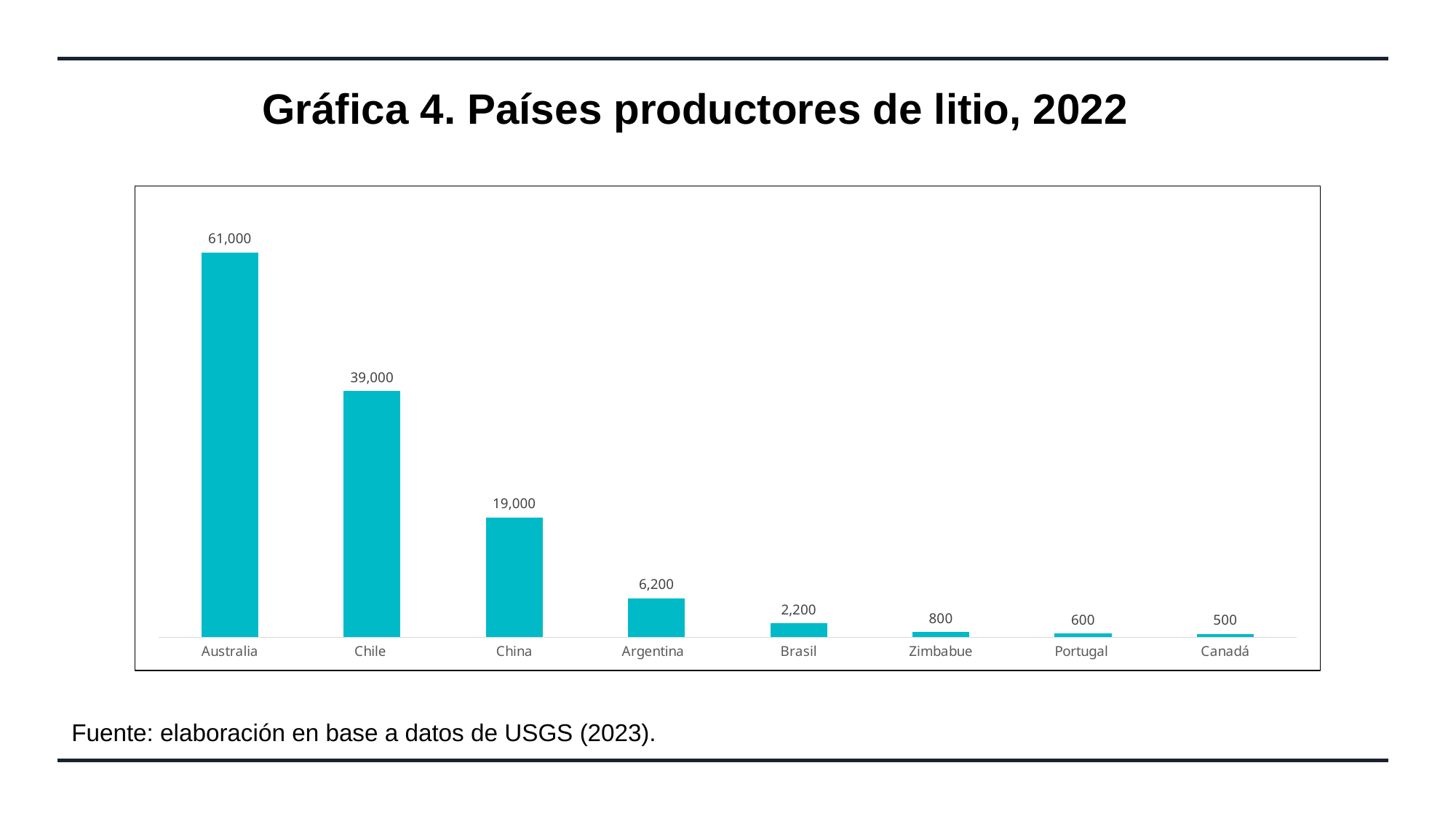
What is the value for Argentina? 6,200 Which country has the highest value? Australia What is the value for Australia? 61,000 Which is larger, the value for Brasil or the value for Portugal? Brasil Which country has the lowest value? Canadá What is the value for Chile? 39,000 What is the value for Zimbabue? 800 What is the difference between the values for Australia and Chile? 22,000 What is the title of the chart? Gráfica 4. Países productores de litio, 2022 How many countries are shown in the chart? 8 What is the difference between the values for China and Argentina? 12,800 What kind of chart is this? Bar chart